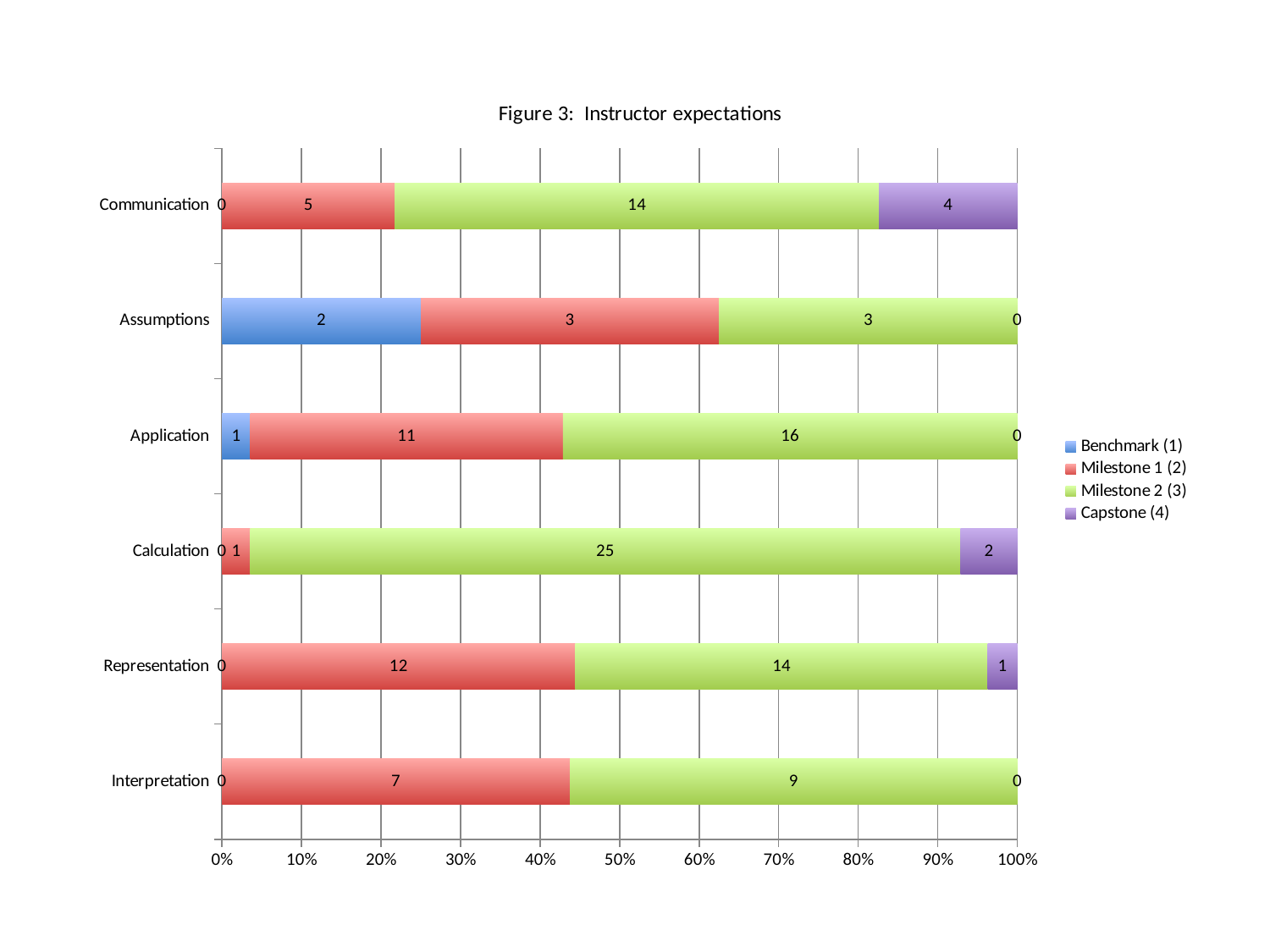
What is the total of all series for the Communication bar? 23 What is the Milestone 2 (3) value for Calculation? 25 Which category has the highest Milestone 2 (3) value? Calculation Which category has the lowest Milestone 2 (3) value? Assumptions What is the Milestone 1 (2) value for Representation? 12 Which is larger for Interpretation: the Milestone 1 (2) value or the Milestone 2 (3) value? Milestone 2 (3) How many categories are shown on the y axis? 6 What kind of chart is shown on the slide? Stacked bar chart What is the Capstone (4) value for Communication? 4 How many series does the legend list? 4 What is the Benchmark (1) value for Assumptions? 2 What is the difference between the Milestone 2 (3) value and the Milestone 1 (2) value for Application? 5